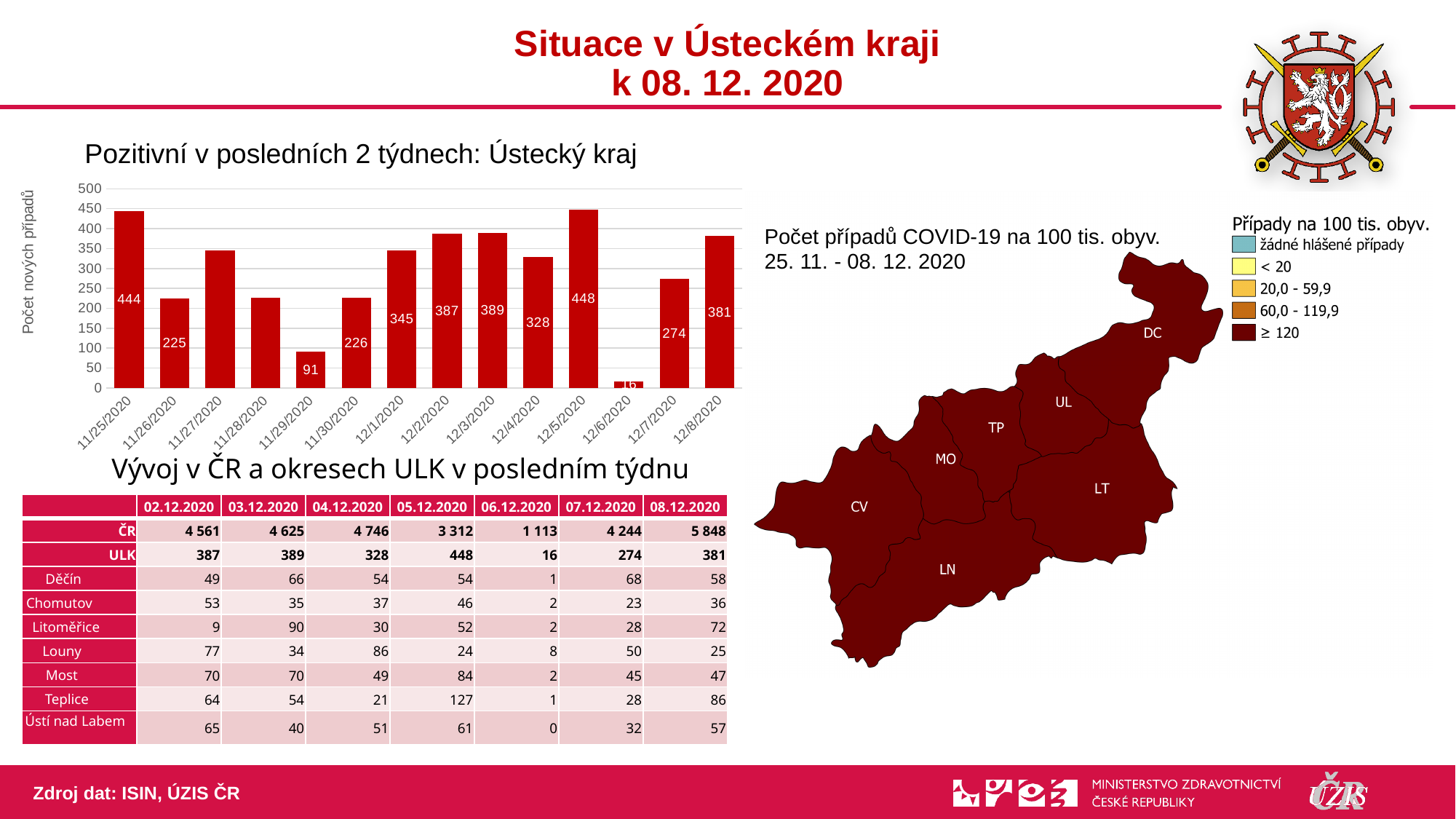
What is the value for 11/29/2020 in the bar chart? 91 What is the y-axis title of the bar chart? Počet nových případů What is the value for 11/25/2020 in the bar chart? 444 What is the difference between the values for 12/5/2020 and 11/25/2020 in the bar chart? 4 Which date has the highest value in the bar chart? 12/5/2020 Which date has the lowest value in the bar chart? 12/6/2020 Is the value for 12/7/2020 in the bar chart greater or less than 250? greater What kind of chart is used to show the positive cases in the last 2 weeks? bar chart Which is larger in the bar chart, the value for 12/2/2020 or for 12/4/2020? 12/2/2020 What is the difference between the values for 12/8/2020 and 12/7/2020 in the bar chart? 107 How many dates are shown on the x axis of the bar chart? 14 What is the value for 12/5/2020 in the bar chart? 448